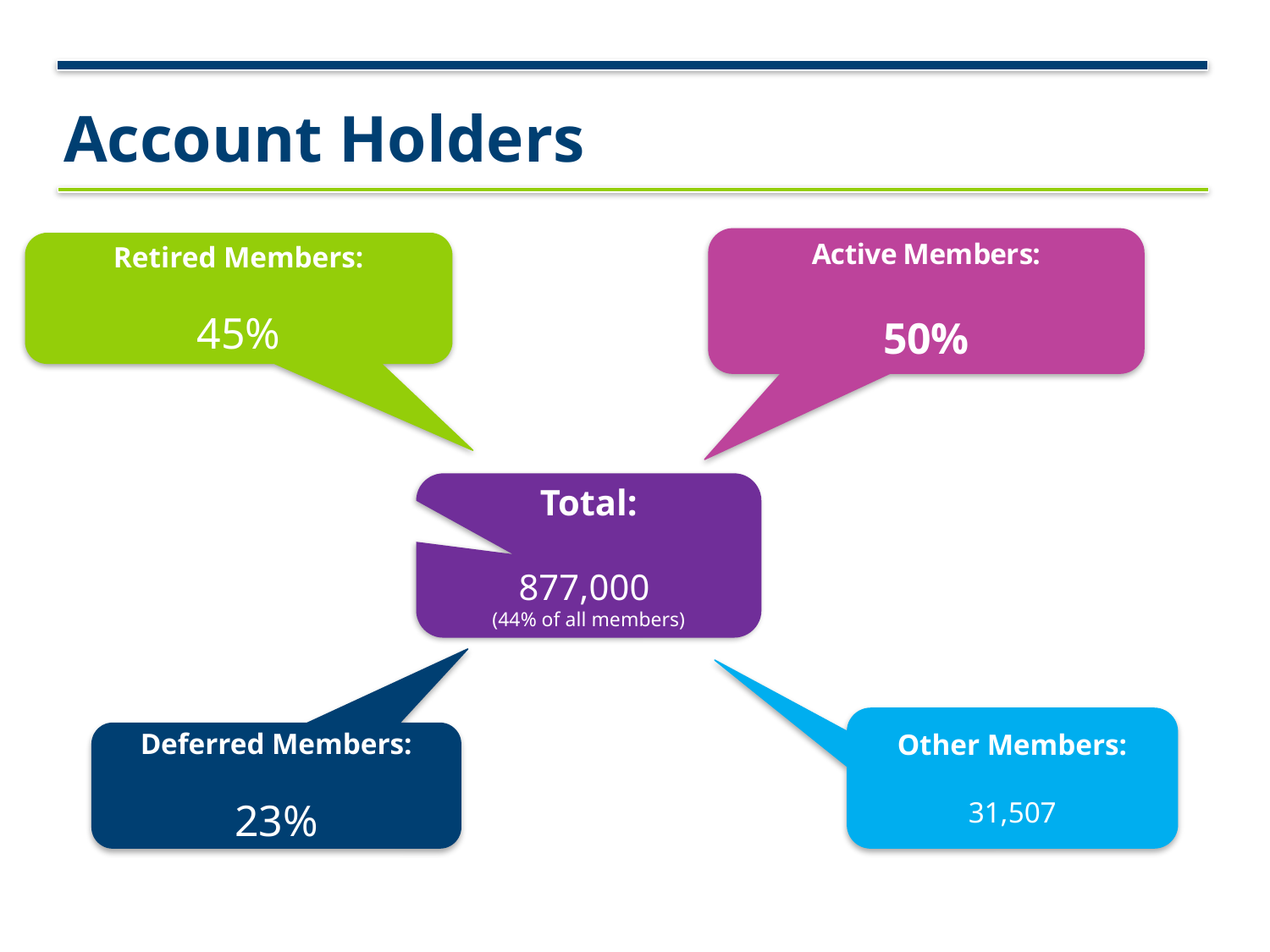
What percentage is shown for Active Members? 50% How many member categories are shown around the Total box? 4 What colour is the Deferred Members callout box? Dark blue What value is shown for Other Members? 31,507 According to the centre box, what share of all members does the total of 877,000 represent? 44% What is the title of the slide? Account Holders What percentage is shown for Retired Members? 45% What percentage is shown for Deferred Members? 23% Which member group shows the lowest percentage: Retired, Active or Deferred Members? Deferred Members What is the total number of account holders shown in the centre box? 877,000 Which is larger, the percentage for Active Members or the percentage for Retired Members? Active Members Which member group shows the highest percentage: Retired, Active or Deferred Members? Active Members